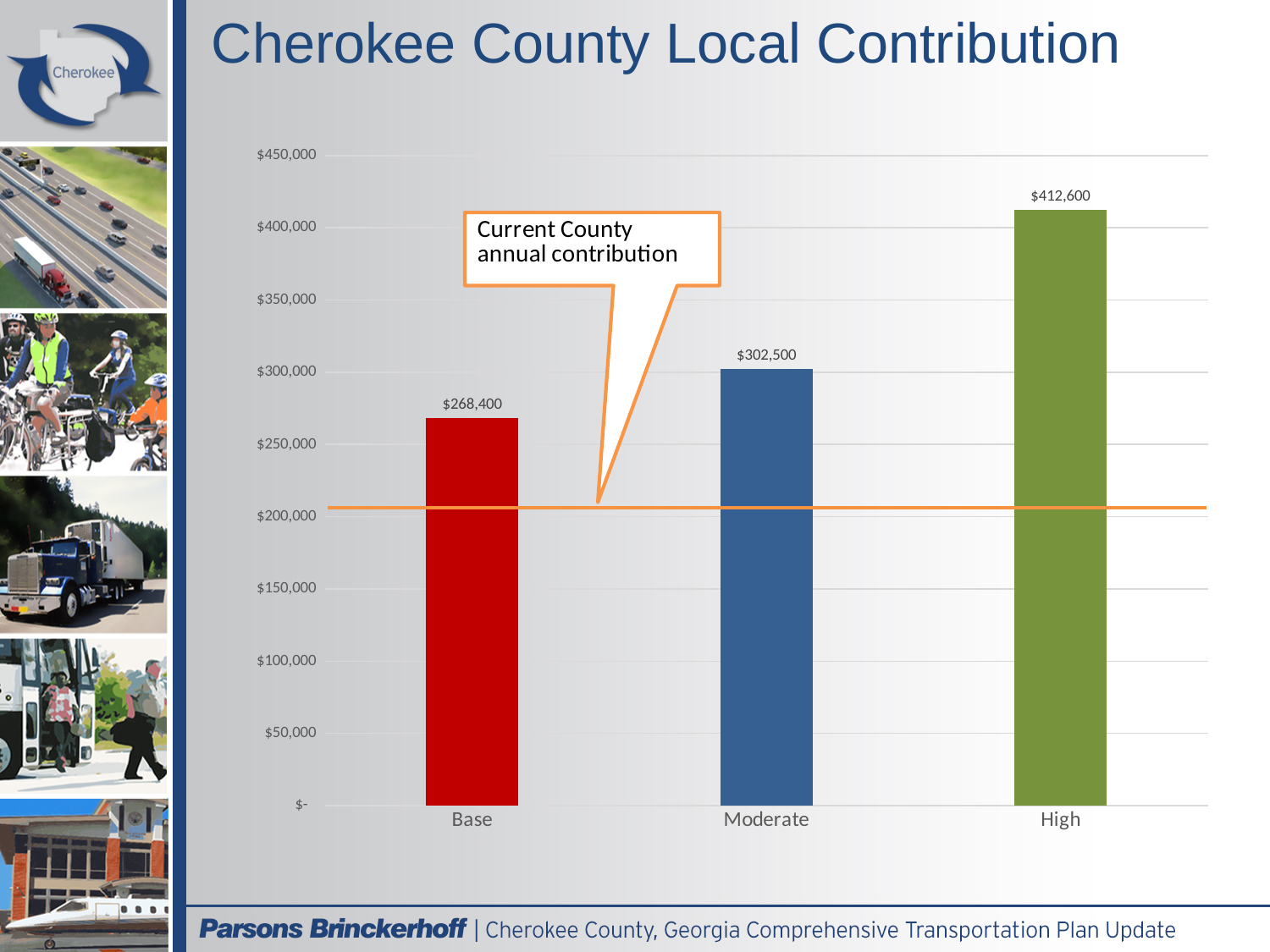
What kind of chart is shown on the slide? Bar chart Is the current County annual contribution line greater or less than $250,000? less What is the value for the Base scenario? $268,400 Which is larger, the value for Moderate or the value for High? High What is the value for the High scenario? $412,600 How many scenarios are shown on the x axis? 3 Which scenario has the highest local contribution? High What is the difference between the Moderate and Base values? $34,100 What does the orange horizontal line represent, according to the callout? Current County annual contribution What is the difference between the High and Base values? $144,200 Which scenario has the lowest local contribution? Base What is the value for the Moderate scenario? $302,500